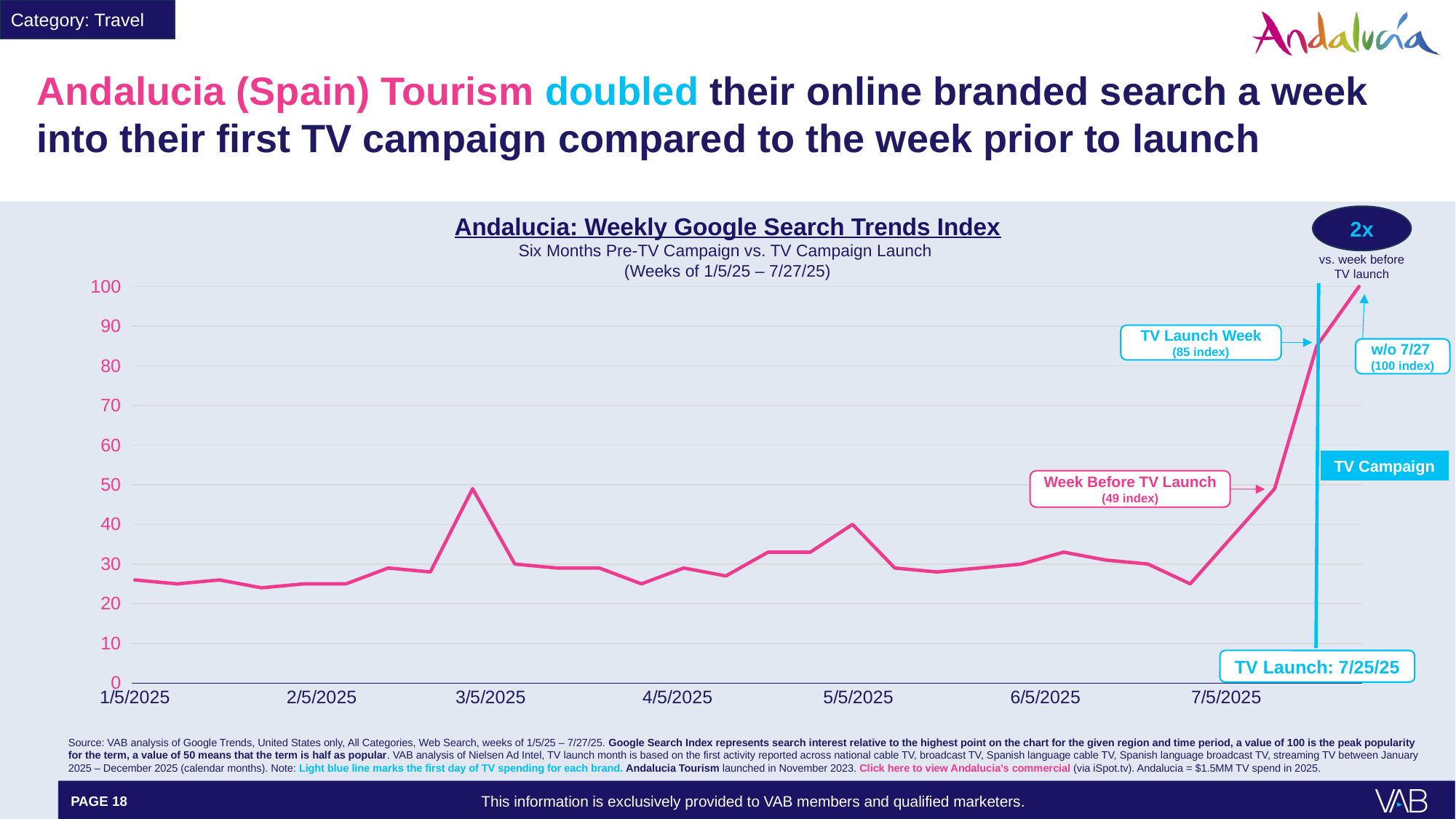
What index value is shown for the week of 7/27? 100 Which labelled week has the highest index value on the chart? w/o 7/27 What is the difference between the w/o 7/27 index and the Week Before TV Launch index? 51 What index value is shown for the TV Launch Week? 85 What kind of chart is shown on the slide? line chart What TV launch date is marked by the light blue vertical line on the chart? 7/25/25 What is the difference between the TV Launch Week index and the Week Before TV Launch index? 36 Which is larger, the index for the TV Launch Week or the index for the Week Before TV Launch? TV Launch Week Is the peak index value near 3/5/2025 greater or less than 40? greater Does the index rise or fall from the week before the TV launch to the week of 7/27? rise What is the Google Search Trends Index value for the week before the TV launch? 49 Is the index value at 1/5/2025 greater or less than 30? less